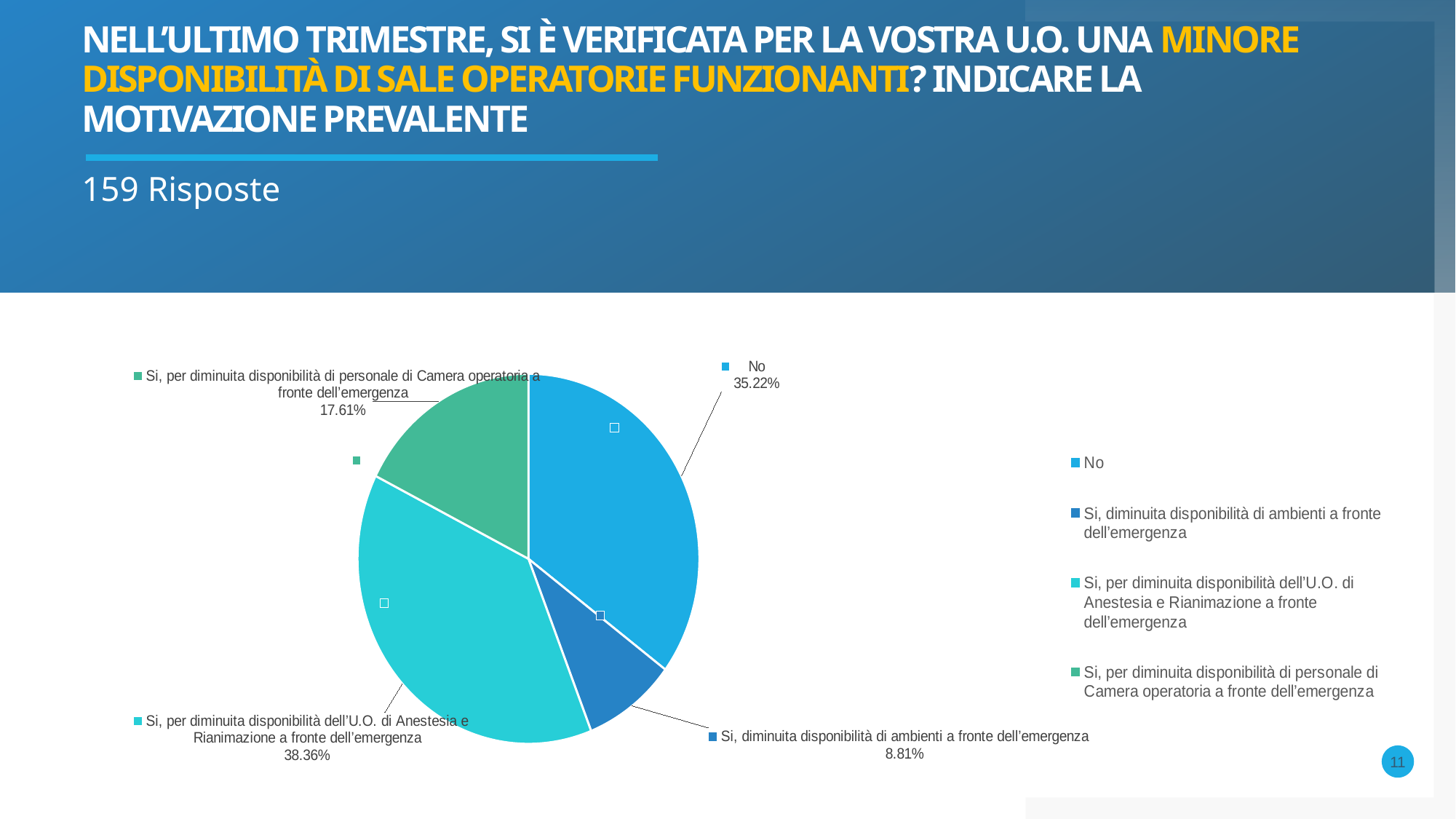
What percentage of responses is "No"? 35.22% What percentage of responses is "Si, per diminuita disponibilità di personale di Camera operatoria a fronte dell'emergenza"? 17.61% Which response category has the smallest share of the pie? Si, diminuita disponibilità di ambienti a fronte dell'emergenza How many responses does the slide say were collected? 159 Which is larger: the share for "No" or the share for "Si, per diminuita disponibilità di personale di Camera operatoria a fronte dell'emergenza"? No What percentage of responses is "Si, per diminuita disponibilità dell'U.O. di Anestesia e Rianimazione a fronte dell'emergenza"? 38.36% What is the difference in percentage points between "No" and "Si, per diminuita disponibilità di personale di Camera operatoria a fronte dell'emergenza"? 17.61 Which response category has the largest share of the pie? Si, per diminuita disponibilità dell'U.O. di Anestesia e Rianimazione a fronte dell'emergenza How many entries does the legend list? 4 What kind of chart is shown on the slide? pie chart How many categories does the pie chart show? 4 What percentage of responses is "Si, diminuita disponibilità di ambienti a fronte dell'emergenza"? 8.81%